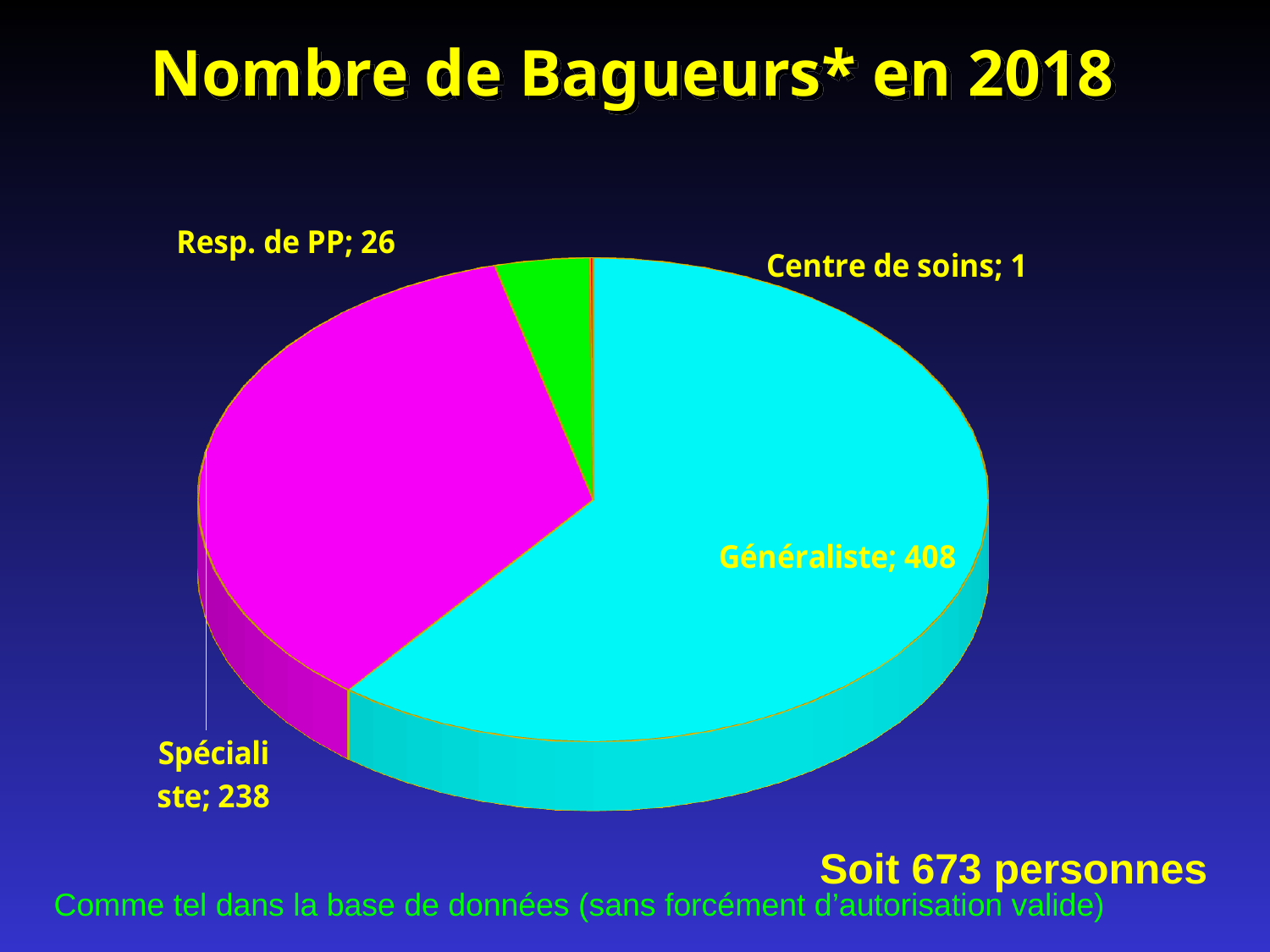
Which category has the smallest slice? Centre de soins What is the value for Centre de soins? 1 What is the total number of people represented by the pie chart, as stated on the slide? 673 What is the difference between the values for Généraliste and Spécialiste? 170 What is the value for Resp. de PP? 26 What kind of chart is shown on the slide? pie chart Which is larger, the value for Resp. de PP or the value for Centre de soins? Resp. de PP What is the value for Généraliste? 408 How many slices does the pie chart have? 4 What is the title of the chart? Nombre de Bagueurs* en 2018 What is the value for Spécialiste? 238 Which category has the largest slice? Généraliste